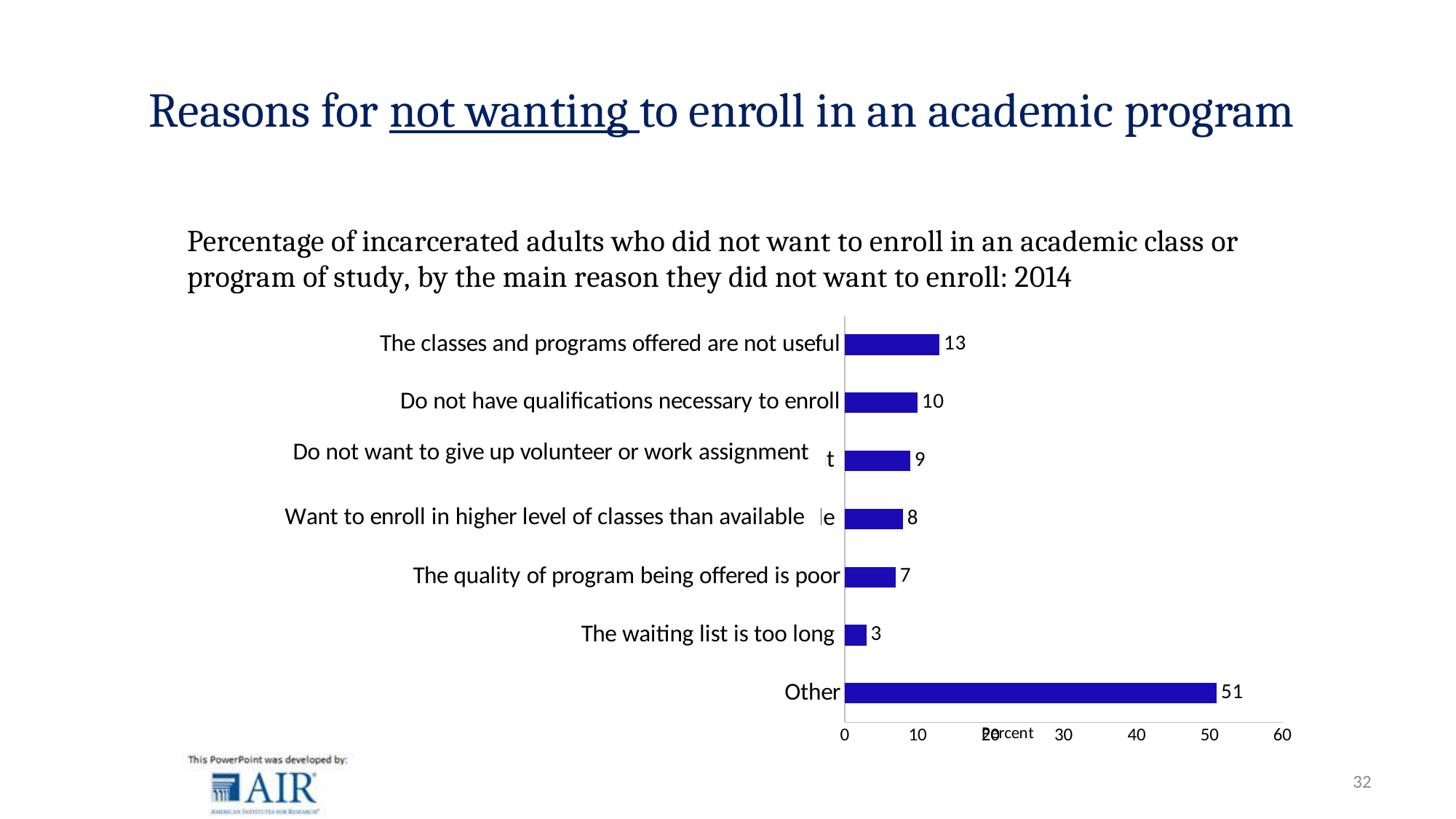
Is the value for "Other" greater or less than 40? greater What is the value for "The quality of program being offered is poor"? 7 Which category has the highest value? Other How many categories are shown in the chart? 7 What is the difference between the values for "Other" and "The classes and programs offered are not useful"? 38 What is the value for "Other"? 51 Which is larger: the value for "Do not have qualifications necessary to enroll" or the value for "Want to enroll in higher level of classes than available"? Do not have qualifications necessary to enroll What is the label on the horizontal axis of the chart? Percent What is the value for "The classes and programs offered are not useful"? 13 What is the value for "The waiting list is too long"? 3 Which category has the lowest value? The waiting list is too long What kind of chart is shown on the slide? Bar chart